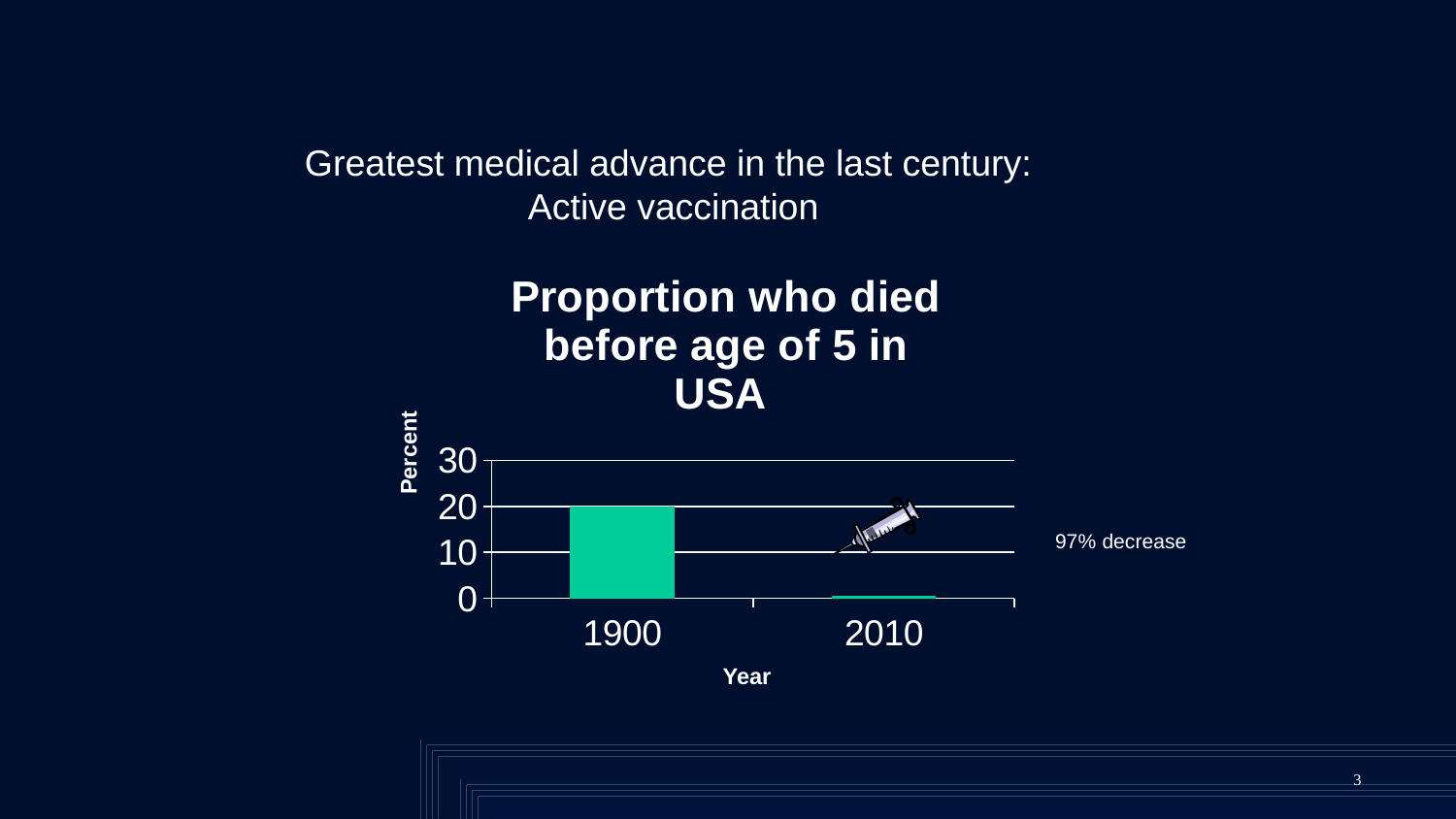
Is the value for 1900 greater or less than 10? greater Which is larger, the value for 1900 or the value for 2010? 1900 What is the label of the vertical axis? Percent Which year has the lowest proportion who died before age 5? 2010 What kind of chart is shown on the slide? bar chart Do the values rise or fall from 1900 to 2010? fall What is the title of the chart? Proportion who died before age of 5 in USA How many years (categories) are plotted on the chart? 2 Is the value for 2010 greater or less than 10? less Which year has the highest proportion who died before age 5? 1900 What is the value for 1900 in percent? 20